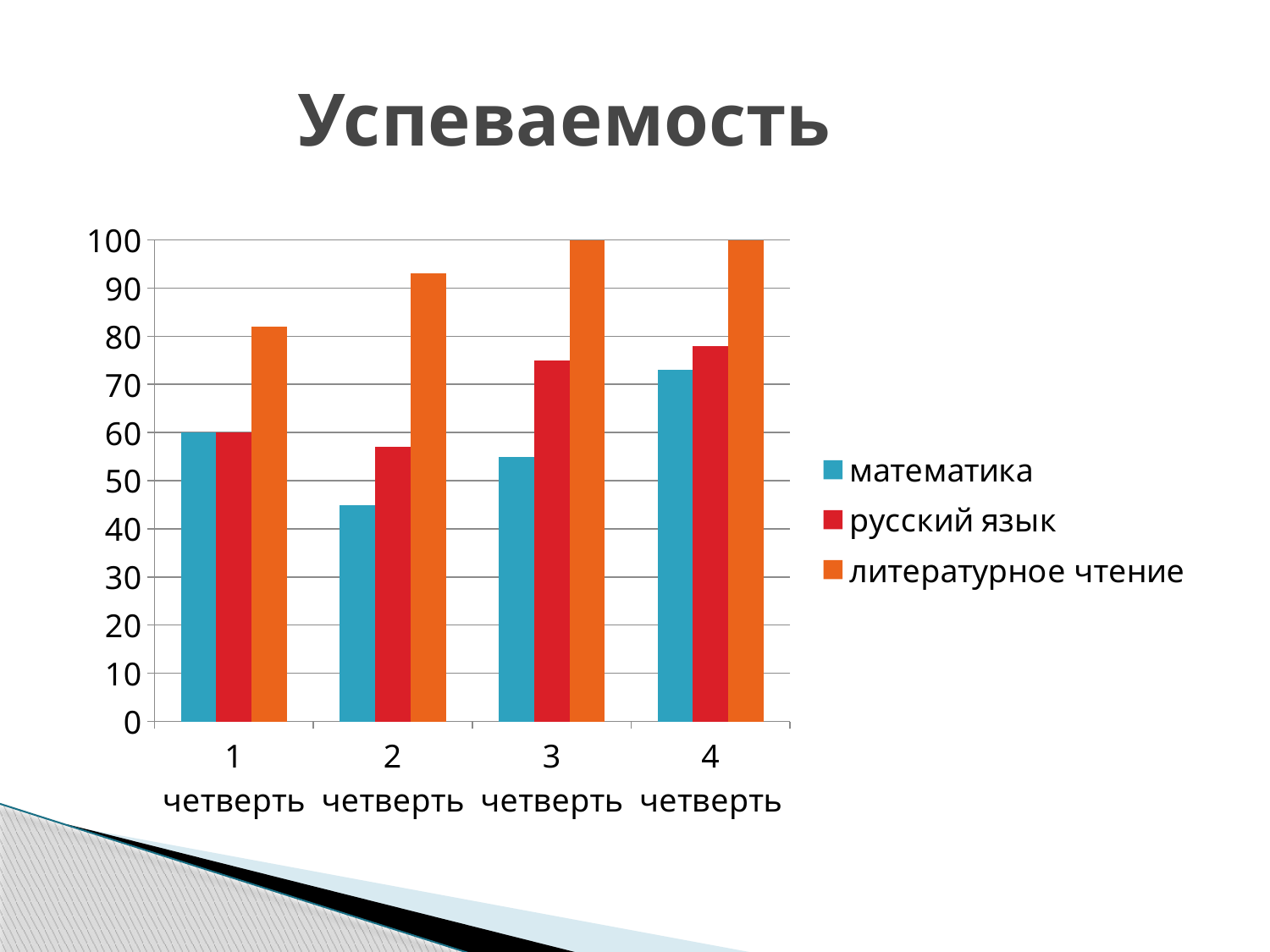
How many categories (четверти) are shown on the x axis? 4 In which четверть is the value for русский язык the highest? 4 четверть What is the value for литературное чтение in 4 четверть? 100 Which is larger in 3 четверть: математика or русский язык? русский язык What kind of chart is shown on the slide? bar chart What is the title of the chart on the slide? Успеваемость How many series does the legend list? 3 Is the value for литературное чтение in 2 четверть greater or less than 90? greater Is the value for русский язык in 4 четверть greater or less than 70? greater What is the value for математика in 1 четверть? 60 Is the value for математика in 2 четверть greater or less than 50? less In which четверть is the value for математика the lowest? 2 четверть